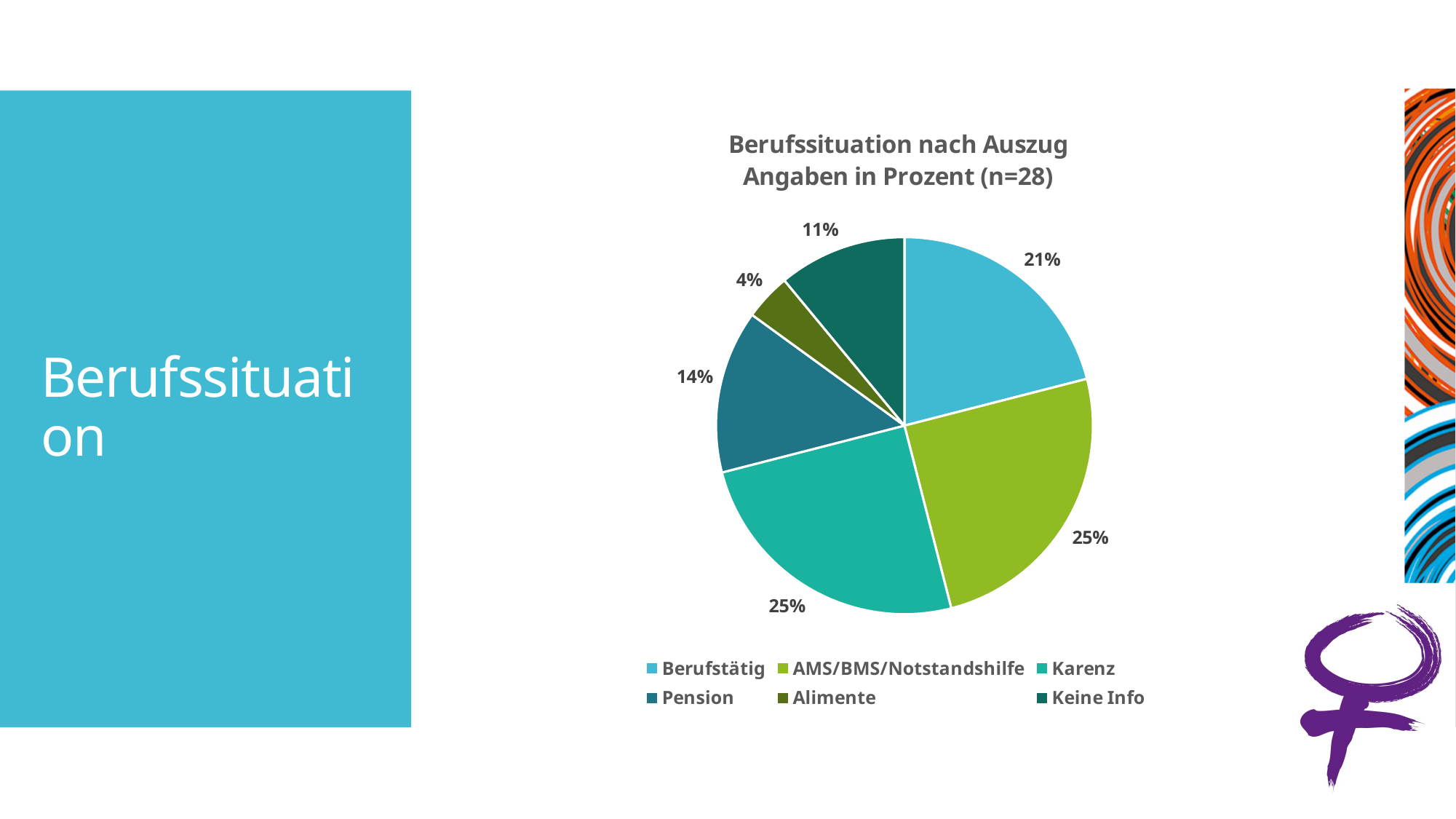
What is the difference in percentage points between Berufstätig and Pension? 7 How many categories does the legend list? 6 What is the title of the chart? Berufssituation nach Auszug Angaben in Prozent (n=28) Which category has the smallest slice of the pie? Alimente What is the difference in percentage points between AMS/BMS/Notstandshilfe and Keine Info? 14 What percentage is shown for Alimente? 4% What percentage of the pie is Berufstätig? 21% Which is larger, the slice for Keine Info or the slice for Alimente? Keine Info What type of chart is shown on the slide? pie chart What percentage is shown for Keine Info? 11% What percentage is shown for Karenz? 25% What percentage is shown for Pension? 14%